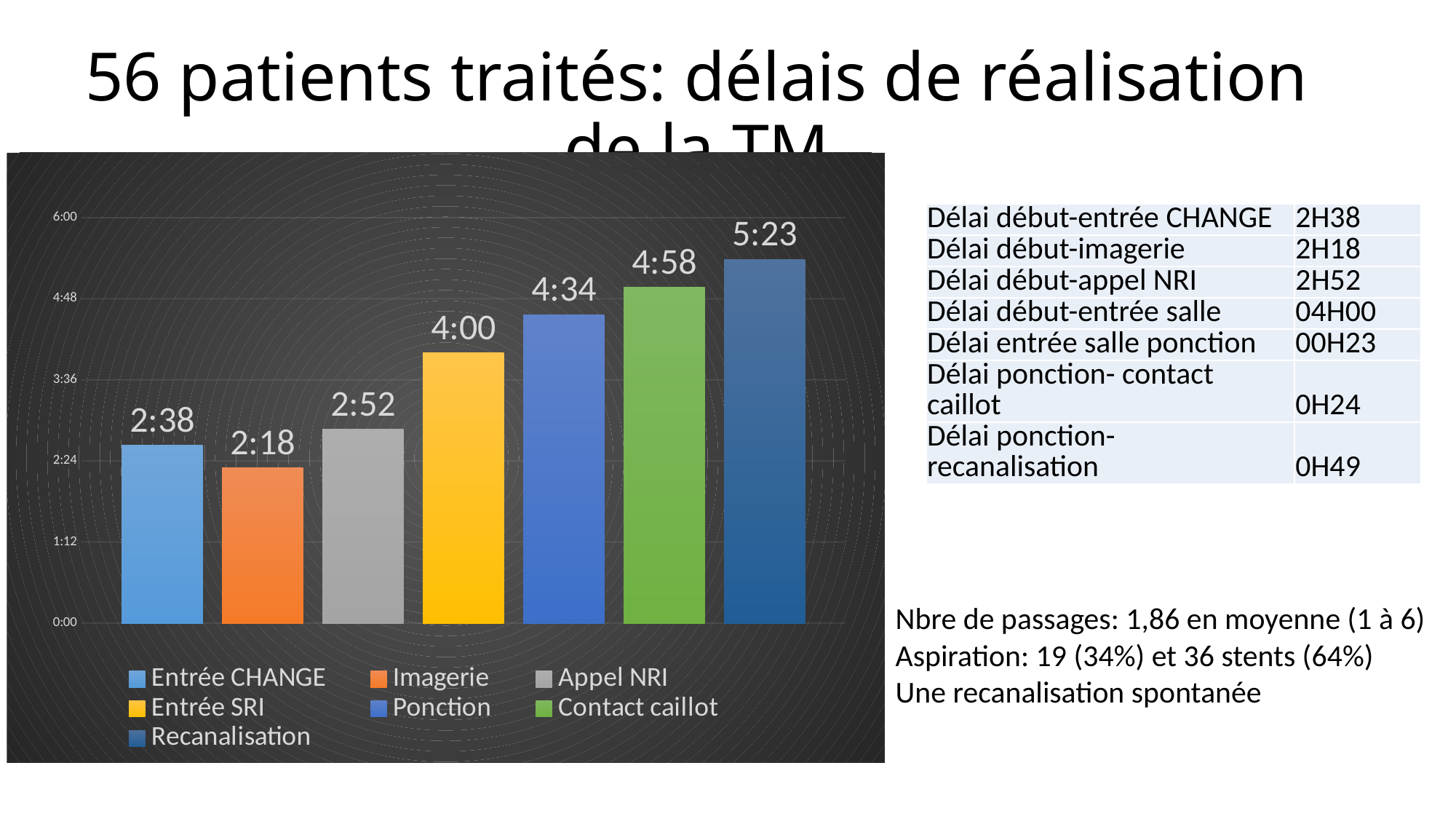
Is the value for Ponction greater or less than 3:36? greater How many bars are plotted in the chart? 7 What is the value shown for Imagerie? 2:18 What is the value shown for Contact caillot? 4:58 Which category has the highest value in the chart? Recanalisation Which category has the lowest value in the chart? Imagerie How many entries does the chart legend list? 7 What is the value shown for Entrée SRI? 4:00 What kind of chart is shown on the slide? Bar chart What is the difference between the values for Recanalisation and Contact caillot? 0:25 Which is larger, the value for Appel NRI or the value for Entrée CHANGE? Appel NRI What is the difference between the values for Ponction and Entrée SRI? 0:34